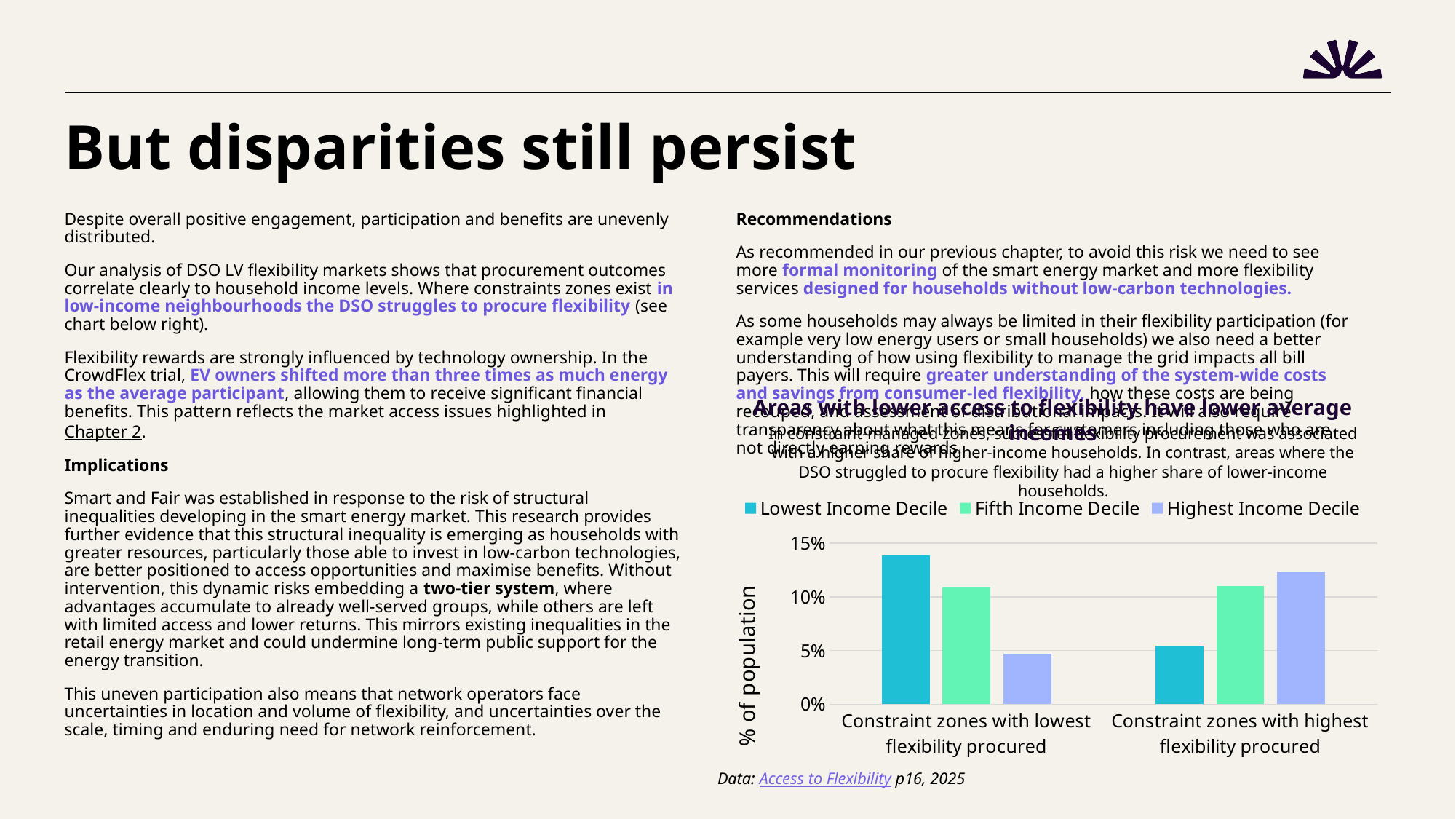
In constraint zones with highest flexibility procured, which is larger: the Lowest Income Decile or the Highest Income Decile? Highest Income Decile Which income decile has the highest share of population in constraint zones with lowest flexibility procured? Lowest Income Decile What is the label on the y axis of the chart? % of population What kind of chart is shown on the slide? Bar chart Is the value for Lowest Income Decile in constraint zones with lowest flexibility procured greater or less than 10%? greater Is the value for Highest Income Decile in constraint zones with highest flexibility procured greater or less than 10%? greater How many categories are shown on the x axis of the chart? 2 Which income decile has the lowest share of population in constraint zones with highest flexibility procured? Lowest Income Decile How many series does the chart legend list? 3 Is the value for Lowest Income Decile in constraint zones with highest flexibility procured greater or less than 10%? less Does the Highest Income Decile value rise or fall from constraint zones with lowest flexibility procured to constraint zones with highest flexibility procured? Rise